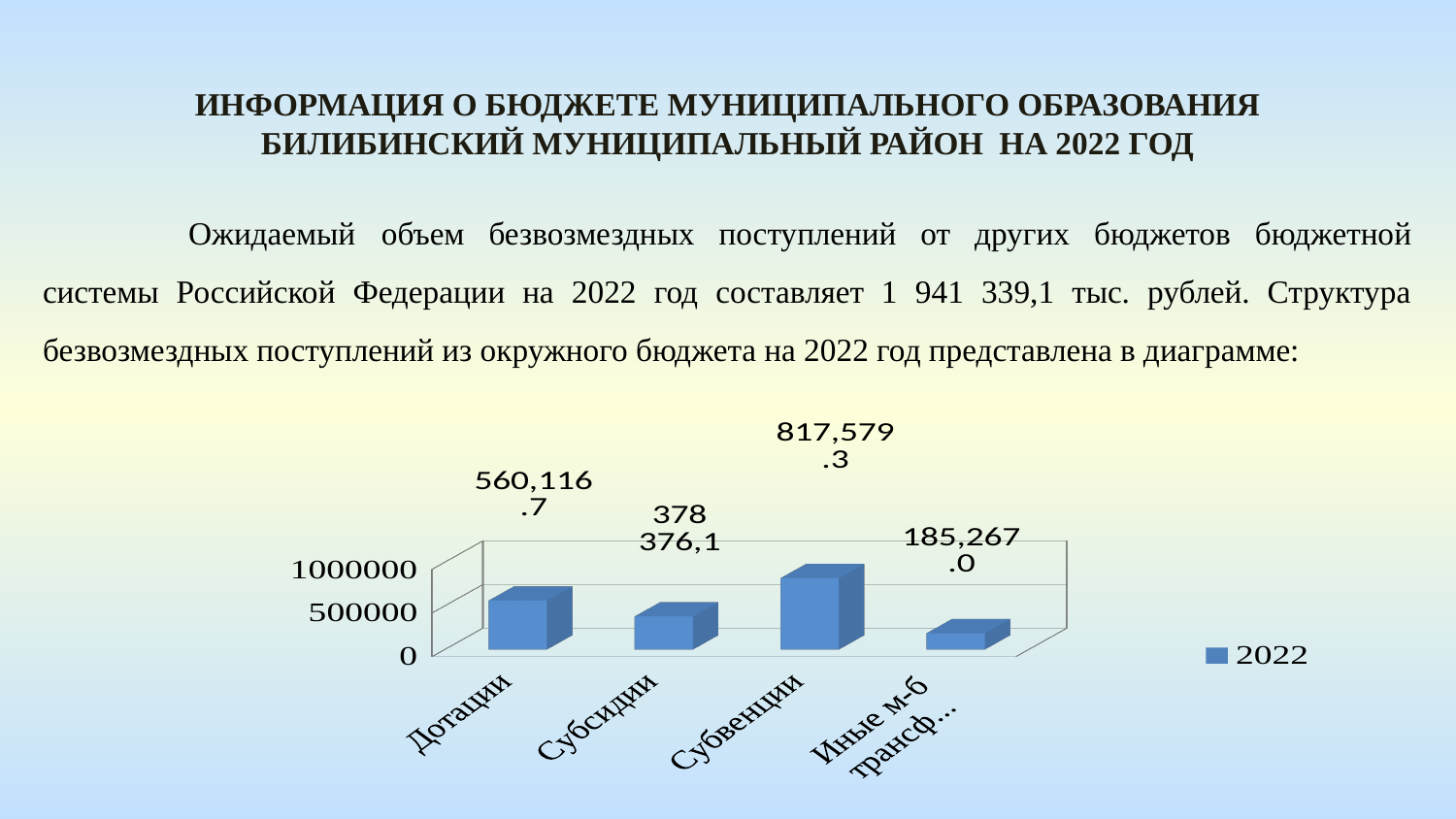
How many series does the legend list? 1 Is the value for Субвенции greater or less than 500000? greater What is the value shown for the rightmost bar (Иные м-б трансф...)? 185,267.0 What is the value for Дотации? 560,116.7 What is the value for Субсидии? 378 376,1 Which category has the highest value? Субвенции Which category has the lowest value? Иные м-б трансф... What kind of chart is shown on the slide? bar chart Which is larger, the value for Дотации or the value for Субсидии? Дотации How many categories are shown on the chart? 4 What is the difference between the values for Субвенции and Дотации? 257,462.6 What is the value for Субвенции? 817,579.3